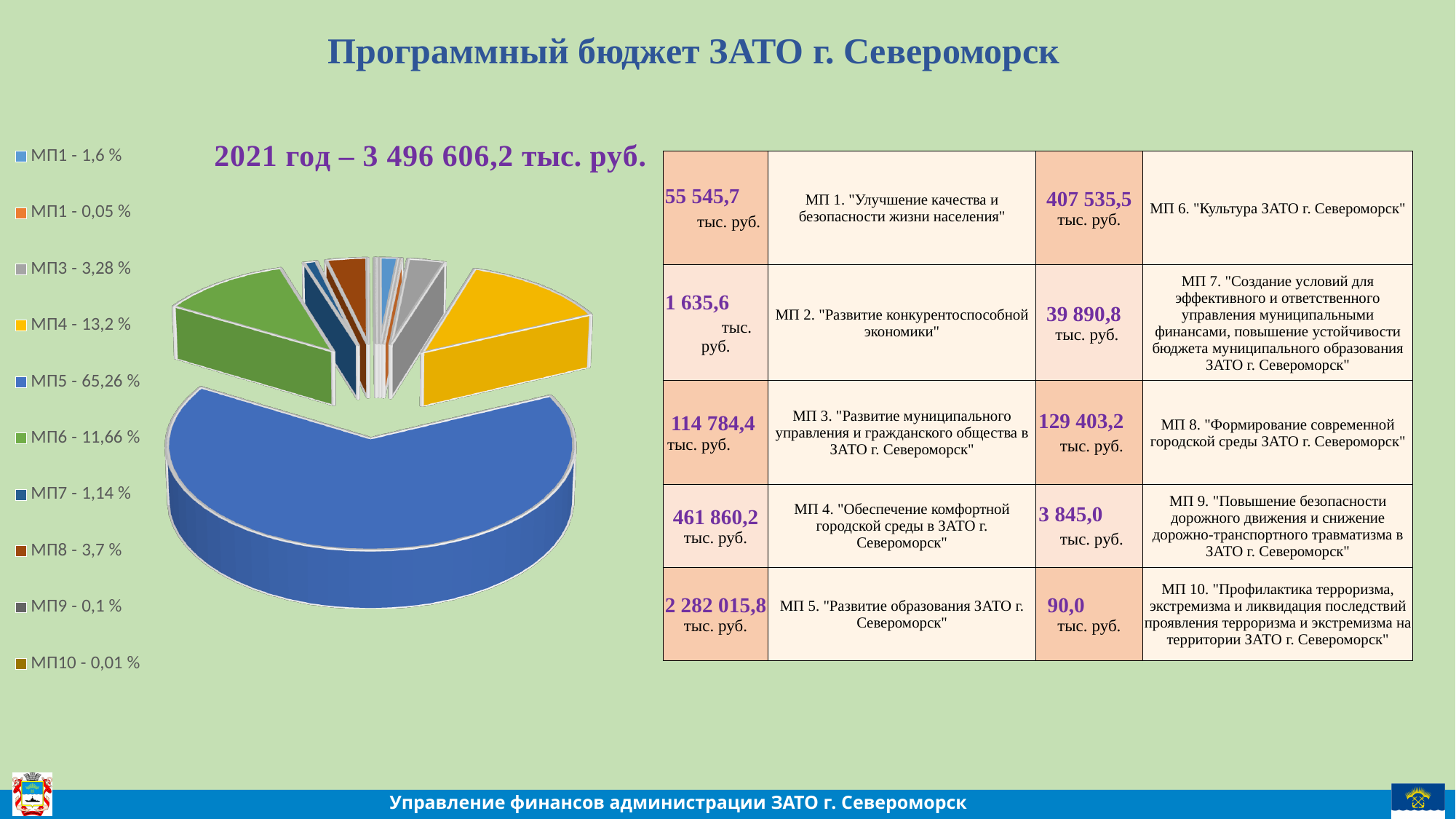
Which legend entry has the smallest share of the pie? МП10 According to the legend, what share of the pie does МП8 have? 3,7 % What total amount for 2021 is stated above the pie chart? 3 496 606,2 тыс. руб. How many entries does the chart legend list? 10 Which legend entry has the largest share of the pie? МП5 According to the legend, what share of the pie does МП5 have? 65,26 % What kind of chart is shown on the slide? pie chart According to the legend, what share of the pie does МП6 have? 11,66 % What is the difference in percentage points between the shares of МП4 and МП6? 1,54 % What colour is the largest slice of the pie (МП5)? blue Which has the larger share of the pie, МП4 or МП6? МП4